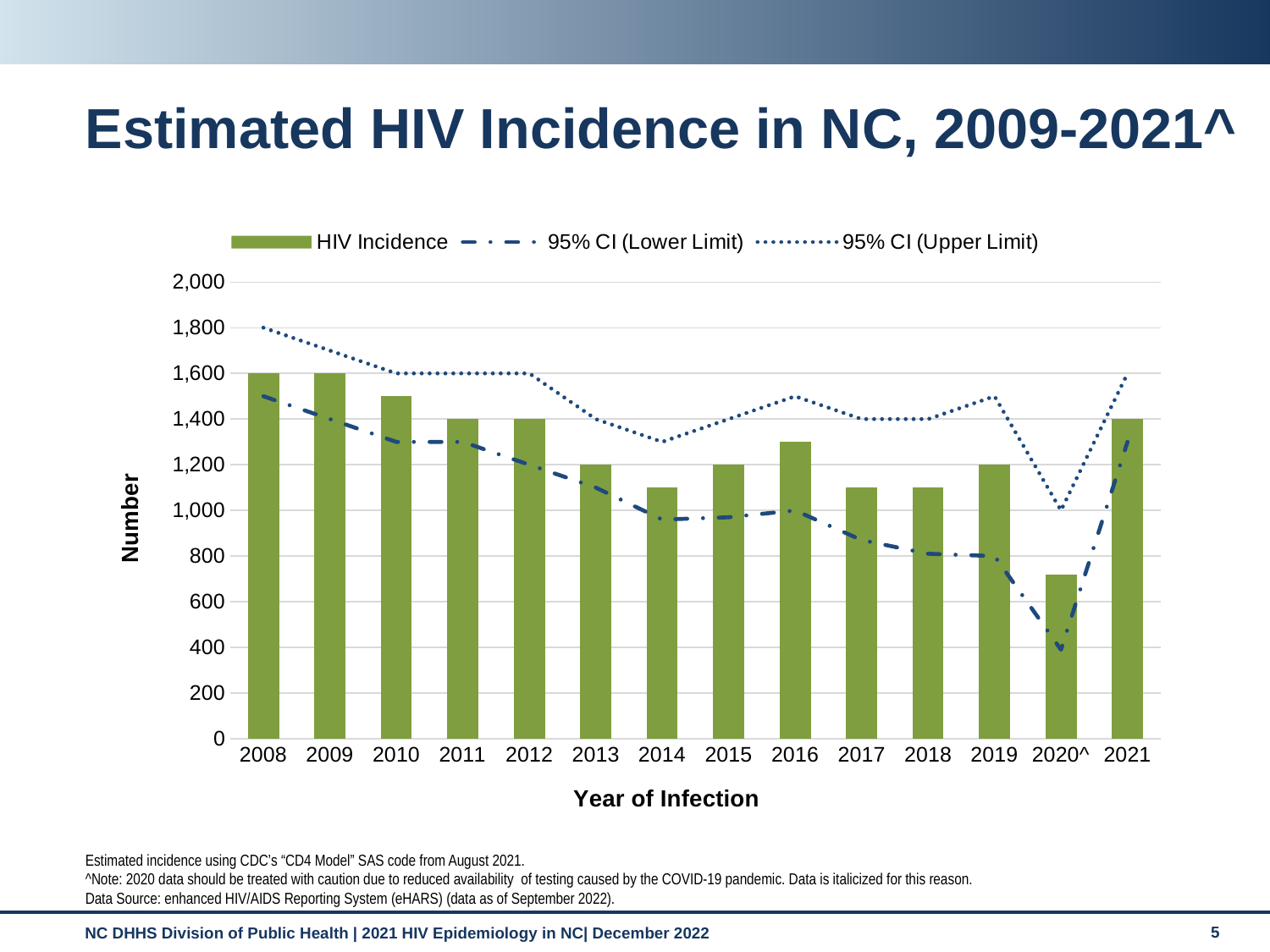
What kind of chart is used to show HIV Incidence? Bar chart Which year has a higher HIV Incidence bar, 2016 or 2017? 2016 What is the HIV Incidence value for 2021? 1,400 What is the difference between the HIV Incidence values for 2008 and 2013? 400 What is the label of the y axis? Number Is the HIV Incidence value for 2020^ greater or less than 800? less How many series does the legend list? 3 What is the HIV Incidence value for 2008? 1,600 How many years are shown on the x axis? 14 What is the HIV Incidence value for 2013? 1,200 Is the HIV Incidence value for 2010 greater or less than 1,400? greater Which year has the lowest HIV Incidence bar? 2020^